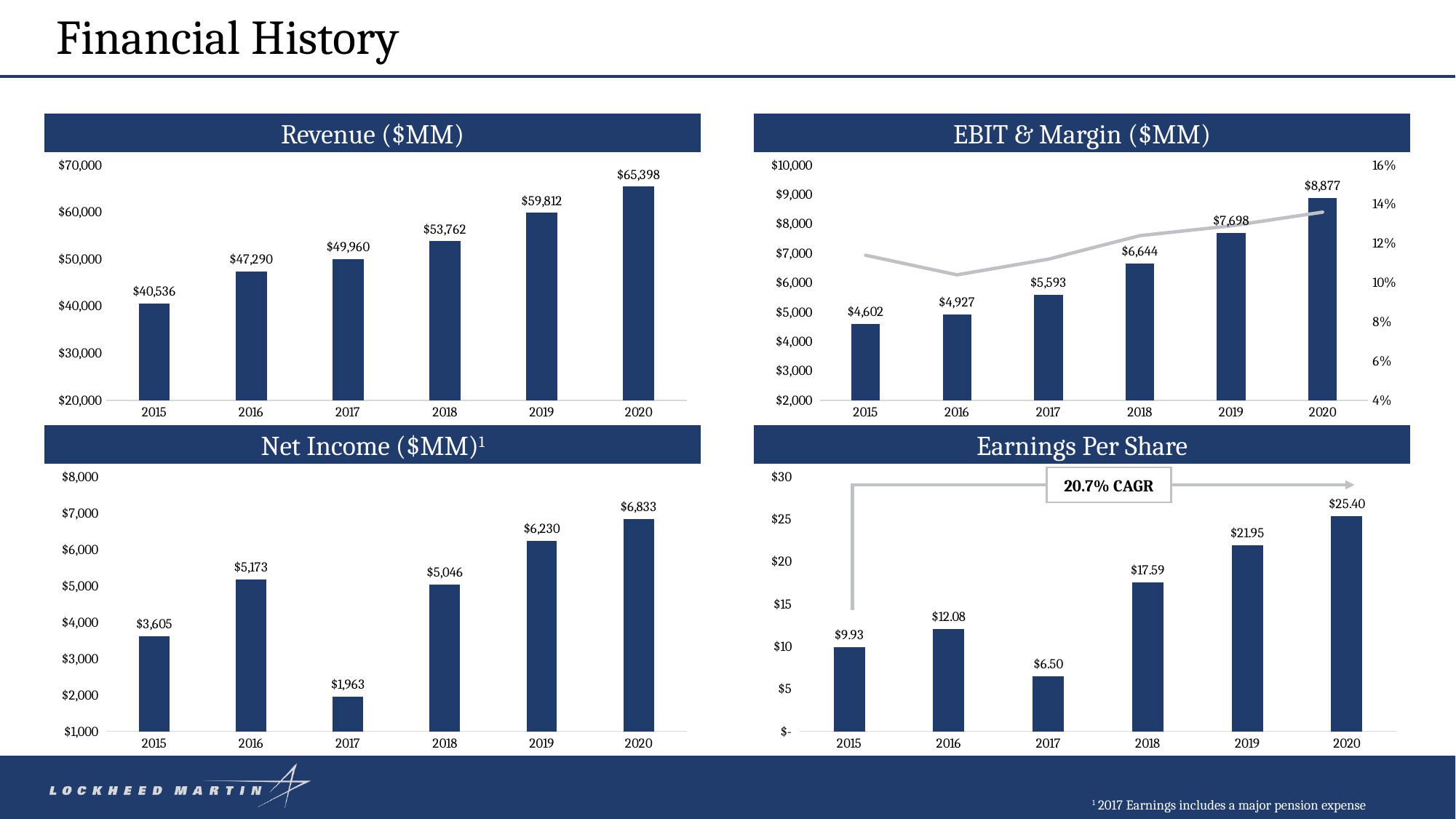
In the EBIT & Margin ($MM) chart, do the EBIT bars rise or fall from 2015 to 2020? rise In the Revenue ($MM) chart, what is the difference between the 2020 and 2015 revenue? $24,862 In the Earnings Per Share chart, how many years are shown on the x axis? 6 In the Earnings Per Share chart, what is the value for 2020? $25.40 In the Revenue ($MM) chart, what is the revenue for 2018? $53,762 In the EBIT & Margin ($MM) chart, what is the EBIT for 2017? $5,593 In the Net Income ($MM) chart, what is the net income for 2019? $6,230 In the EBIT & Margin ($MM) chart, is the margin line for 2016 greater or less than 12%? less In the Net Income ($MM) chart, which is larger, the net income for 2016 or 2018? 2016 In the Revenue ($MM) chart, which year has the highest revenue? 2020 In the Net Income ($MM) chart, which year has the lowest net income? 2017 What CAGR is shown in the Earnings Per Share chart? 20.7% CAGR